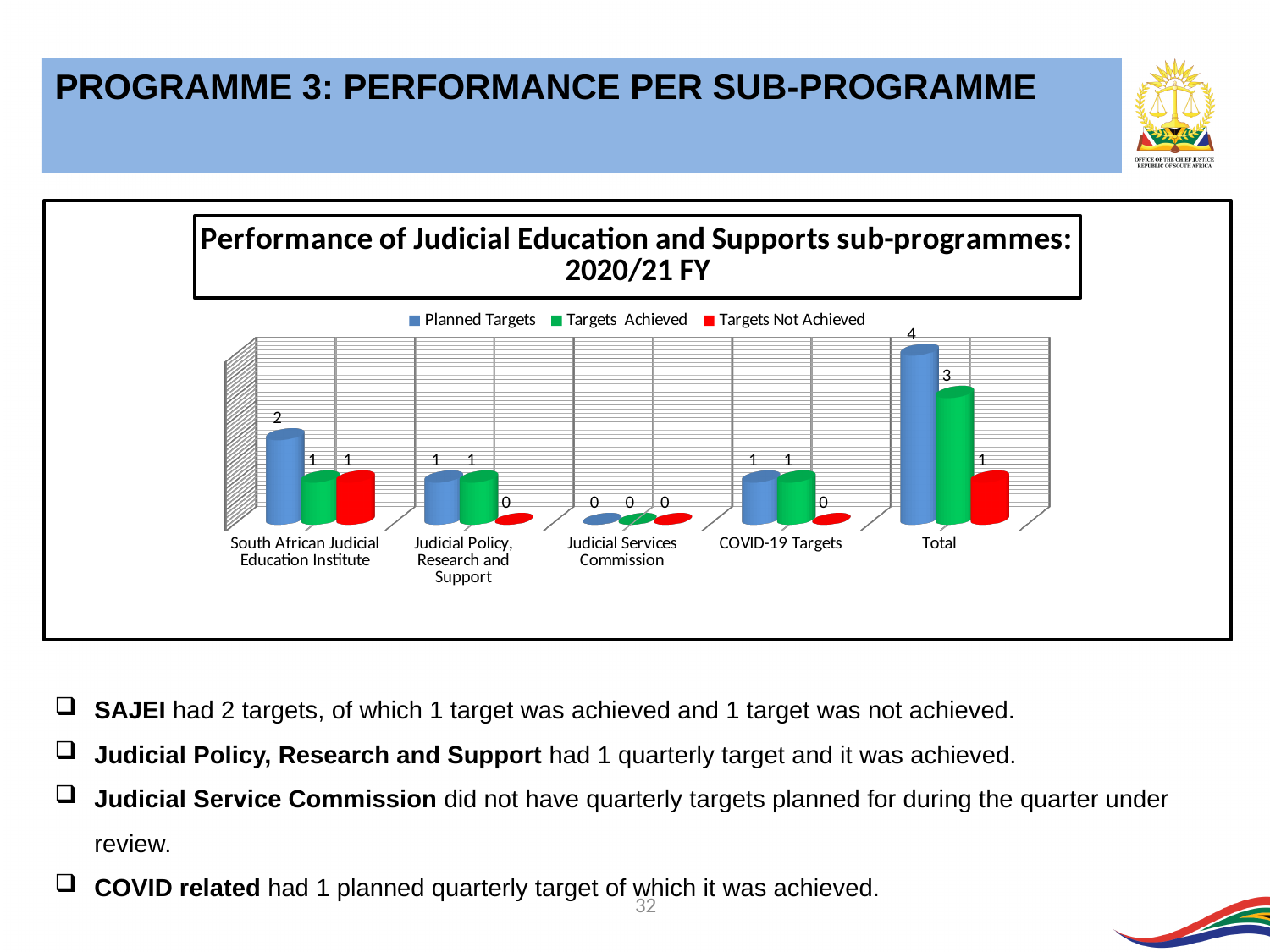
What is the Targets Not Achieved value for COVID-19 Targets? 0 What is the Planned Targets value for Judicial Services Commission? 0 Which category has the highest Planned Targets value? Total What is the Planned Targets value for South African Judicial Education Institute? 2 What is the title of the chart? Performance of Judicial Education and Supports sub-programmes: 2020/21 FY What kind of chart is shown? Bar chart What is the difference between Planned Targets and Targets Achieved for Total? 1 Which is larger: Planned Targets for South African Judicial Education Institute or Planned Targets for COVID-19 Targets? South African Judicial Education Institute How many series does the legend list? 3 Which colour represents Targets Not Achieved in the legend? Red What is the Targets Achieved value for Total? 3 How many categories are shown on the x axis? 5